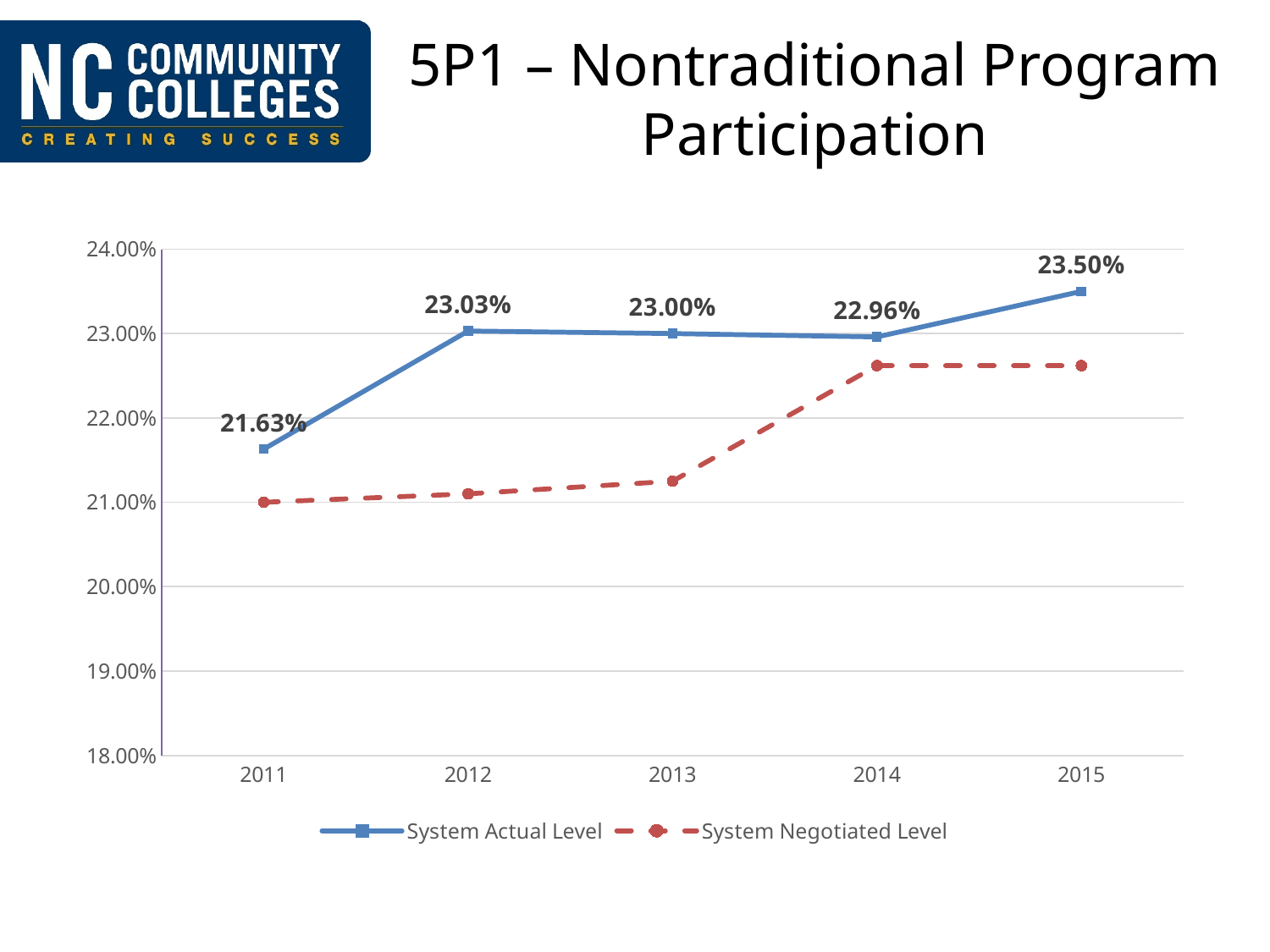
What kind of chart is shown on the slide? line chart How many series does the legend list? 2 Which year has the larger System Actual Level, 2012 or 2013? 2012 Is the System Negotiated Level for 2014 greater or less than 22.00%? greater By how much did the System Actual Level increase from 2011 to 2015? 1.87% Is the System Negotiated Level for 2011 greater or less than 22.00%? less In which year is the System Actual Level lowest? 2011 What is the System Actual Level for 2011? 21.63% In which year is the System Actual Level highest? 2015 What is the System Actual Level for 2014? 22.96% What is the System Actual Level for 2015? 23.50% How many years are shown on the x axis? 5